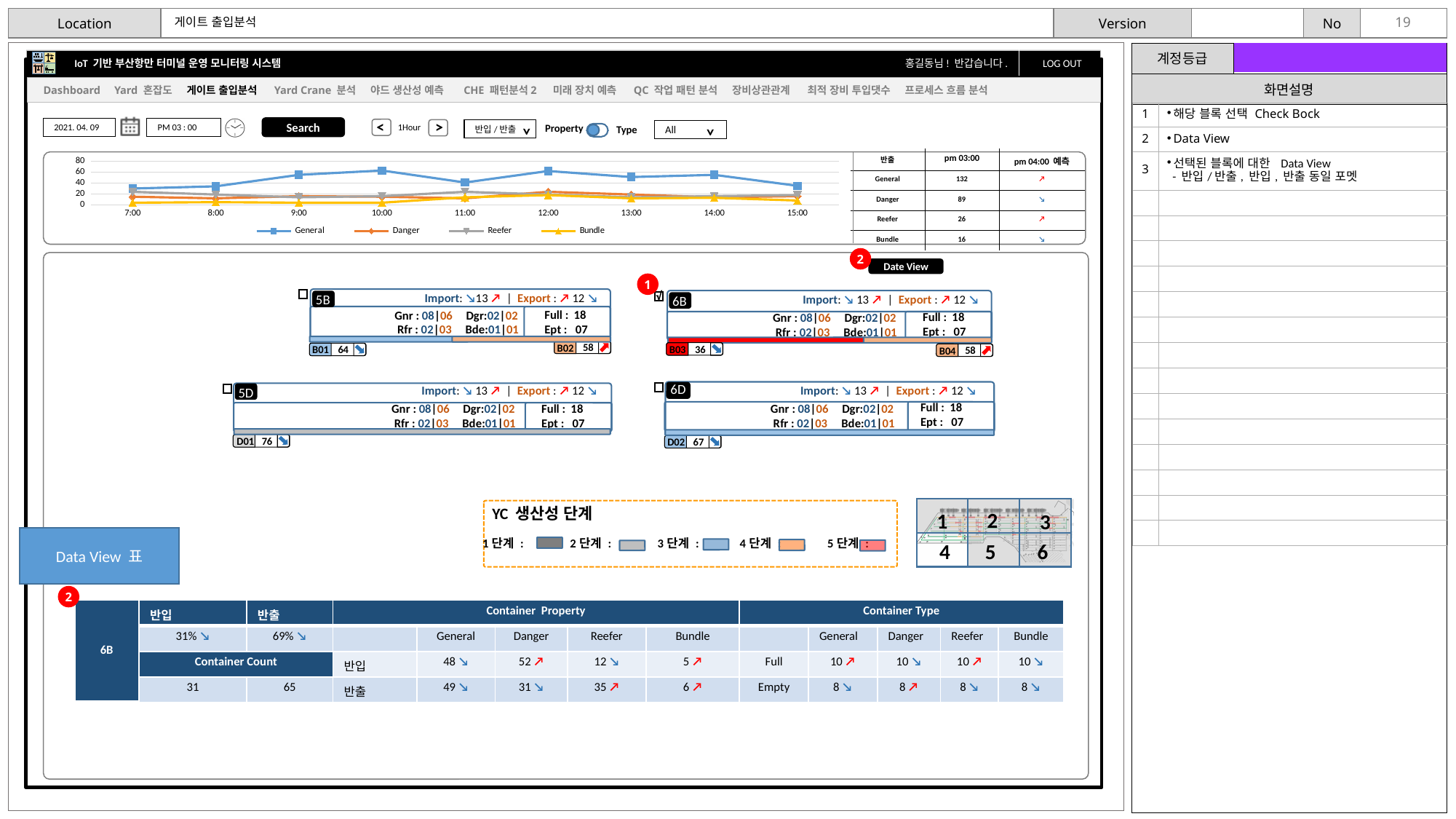
In the top line chart, is the value for General at 7:00 greater or less than 40? less In the top line chart, is the value for General at 10:00 greater or less than 40? greater Which series has the highest values across the top line chart? General What colour is the General series in the top line chart? blue In the top line chart, does the General series rise or fall from 14:00 to 15:00? fall In the top line chart, is the value for General at 9:00 greater or less than 40? greater In the top line chart, does the General series rise or fall from 7:00 to 9:00? rise What kind of chart is shown at the top of the slide? line chart How many time points are shown along the x axis of the top line chart? 9 How many series does the legend of the top line chart list? 4 In the top line chart, which is larger at 10:00, General or Bundle? General